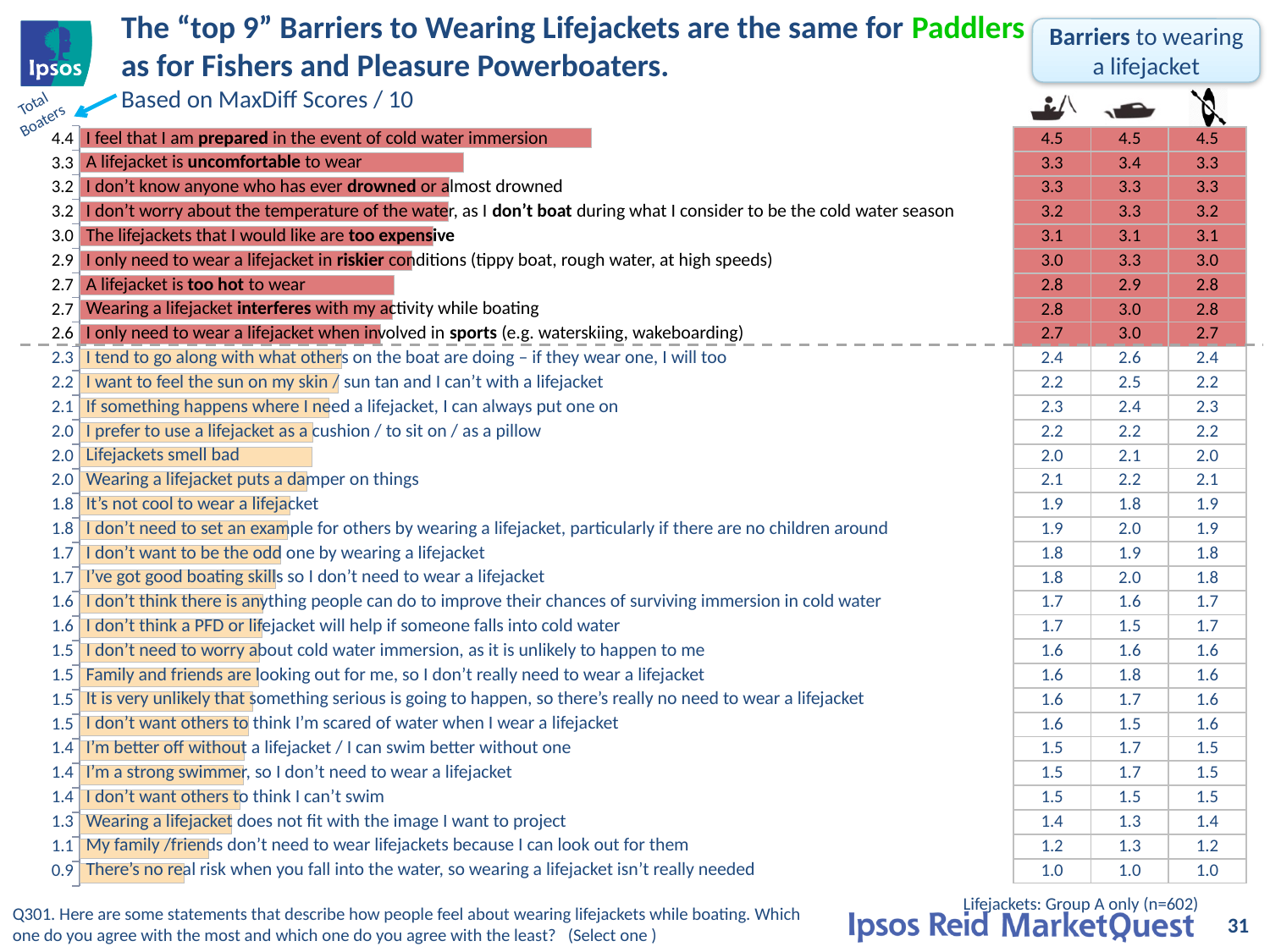
What kind of chart is used to show the Total Boaters scores? Bar chart Do the Total Boaters scores increase or decrease going from the top bar to the bottom bar? Decrease Which barrier has the highest Total Boaters score in the bar chart? I feel that I am prepared in the event of cold water immersion How many bars are shaded red (the top group above the dashed line) in the chart? 9 What is the Total Boaters MaxDiff score for "I feel that I am prepared in the event of cold water immersion"? 4.4 Which has the higher Total Boaters score: "A lifejacket is too hot to wear" or "Lifejackets smell bad"? A lifejacket is too hot to wear What is the Total Boaters score for "Lifejackets smell bad"? 2.0 What is the Total Boaters score for "The lifejackets that I would like are too expensive"? 3.0 What is the Total Boaters score for "It's not cool to wear a lifejacket"? 1.8 According to the subtitle, what are the chart values based on? MaxDiff Scores / 10 What is the difference between the Total Boaters scores for "I feel that I am prepared in the event of cold water immersion" and "A lifejacket is uncomfortable to wear"? 1.1 Which barrier has the lowest Total Boaters score in the bar chart? There's no real risk when you fall into the water, so wearing a lifejacket isn't really needed